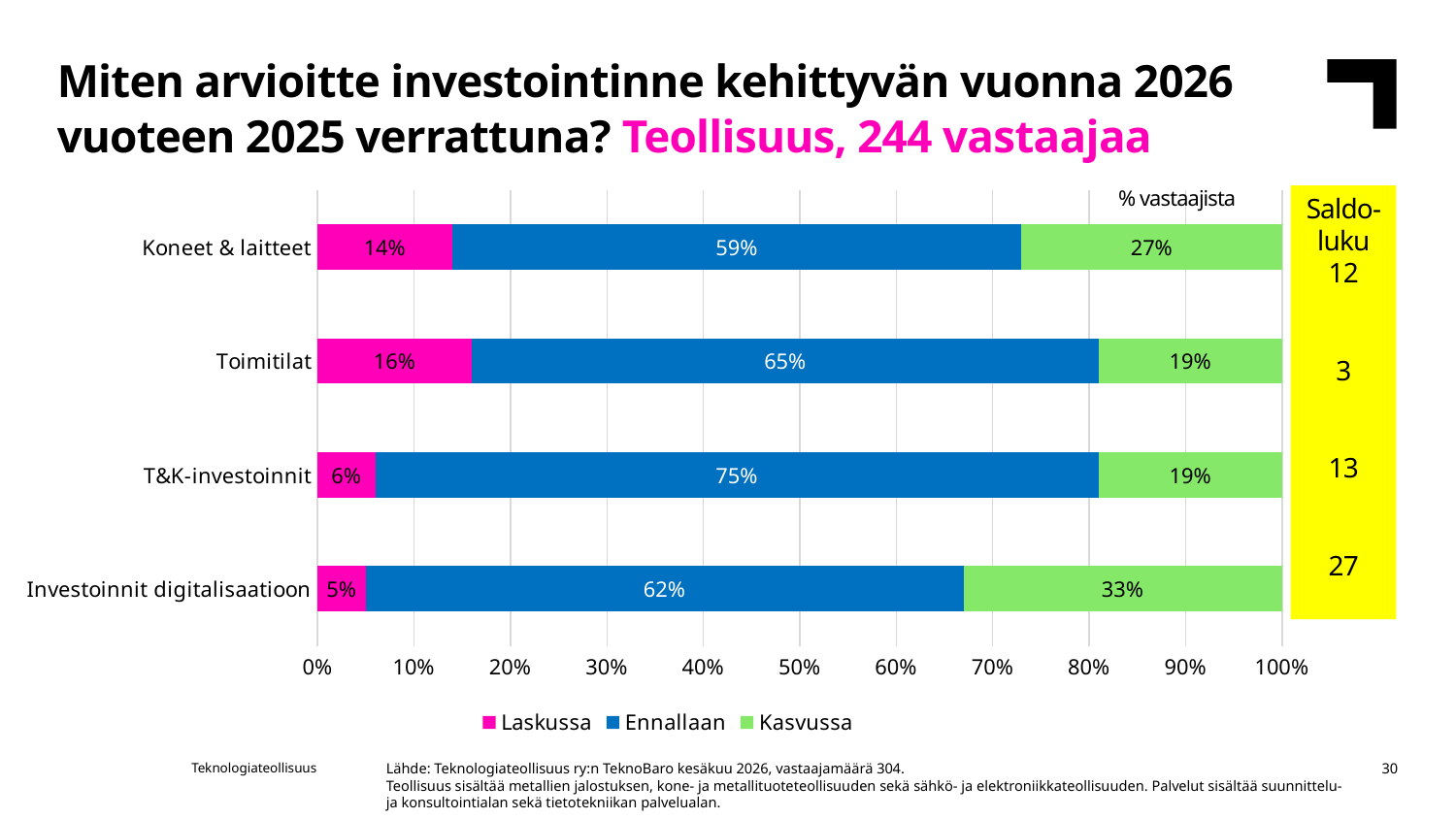
What is the Kasvussa value for Investoinnit digitalisaatioon? 33% Which category has the highest Ennallaan share? T&K-investoinnit Which category has the lowest Laskussa share? Investoinnit digitalisaatioon Which series is shown in blue in the legend? Ennallaan Which is larger: the Laskussa value for Toimitilat or for Koneet & laitteet? Toimitilat What percentage of respondents expect Koneet & laitteet investments to be Ennallaan? 59% What is the difference between the Kasvussa values for Investoinnit digitalisaatioon and Koneet & laitteet? 6 percentage points What is the Laskussa value for T&K-investoinnit? 6% What kind of chart is shown on the slide? Stacked bar chart How many series does the legend list? 3 How many categories are shown on the chart? 4 What is the Saldoluku value shown for Investoinnit digitalisaatioon? 27